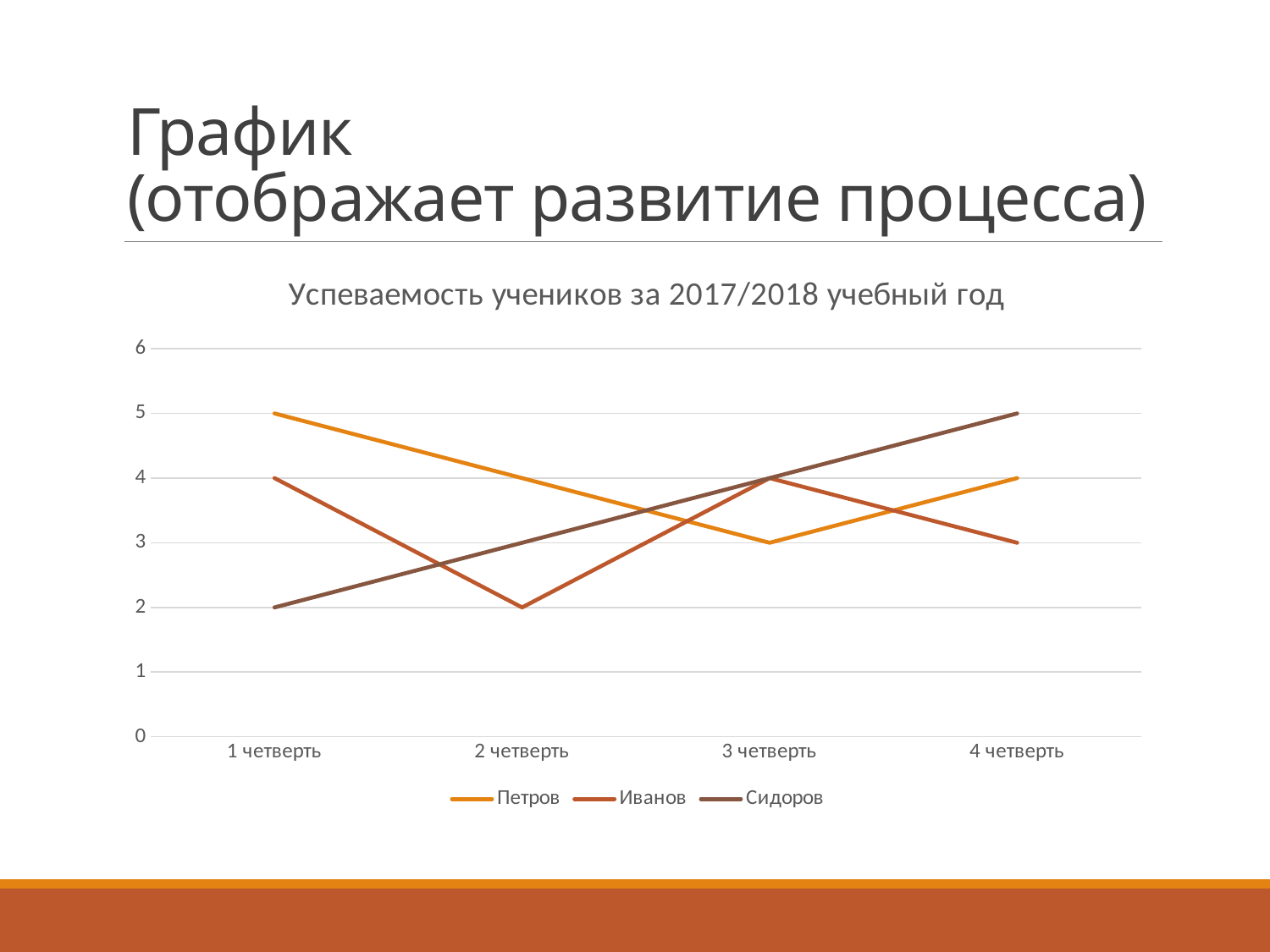
How many series does the legend list? 3 What is the value for Сидоров in 4 четверть? 5 Do the values for Сидоров rise or fall from 1 четверть to 4 четверть? rise What is the value for Иванов in 2 четверть? 2 In which quarter is the value for Петров highest? 1 четверть Which is larger in 1 четверть, the value for Петров or the value for Сидоров? Петров What is the value for Петров in 1 четверть? 5 How many categories are shown on the x axis? 4 What is the title of the chart? Успеваемость учеников за 2017/2018 учебный год What kind of chart is shown on the slide? line chart In which quarter is the value for Сидоров lowest? 1 четверть What is the difference between Сидоров and Иванов in 4 четверть? 2